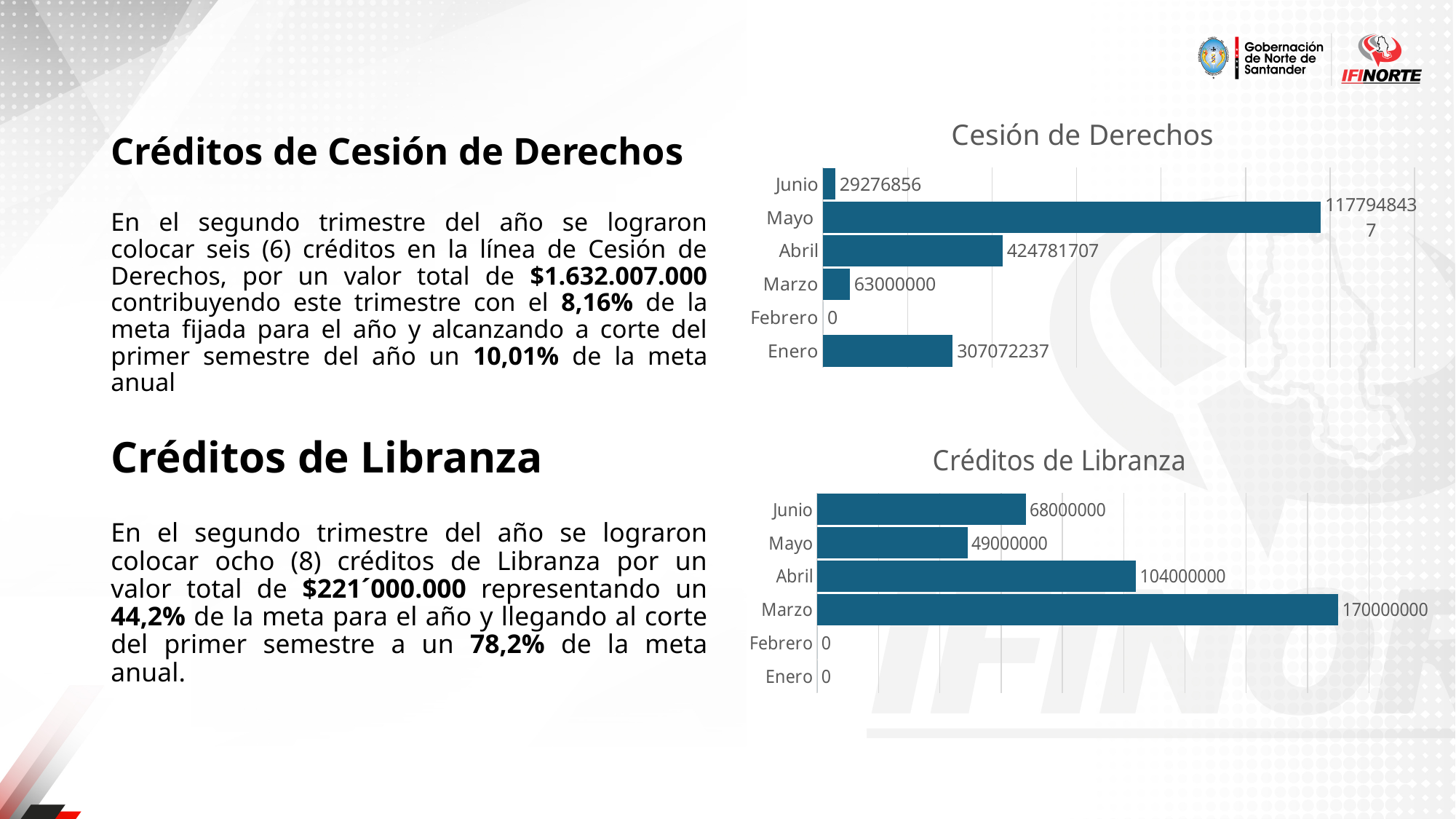
In the Cesión de Derechos chart, what is the difference between the values for Abril and Enero? 117709470 In the Cesión de Derechos chart, what is the value for Abril? 424781707 In the Créditos de Libranza chart, what is the value for Mayo? 49000000 In the Cesión de Derechos chart, which month has the highest value? Mayo In the Cesión de Derechos chart, which is larger, the value for Junio or the value for Marzo? Marzo In the Cesión de Derechos chart, which month has the lowest value? Febrero In the Créditos de Libranza chart, which month has the highest value? Marzo What type of chart is the Cesión de Derechos chart? Bar chart In the Créditos de Libranza chart, what is the difference between the values for Marzo and Abril? 66000000 In the Cesión de Derechos chart, what is the value for Enero? 307072237 In the Créditos de Libranza chart, how many months have a value of 0? 2 How many months are shown in the Créditos de Libranza chart? 6